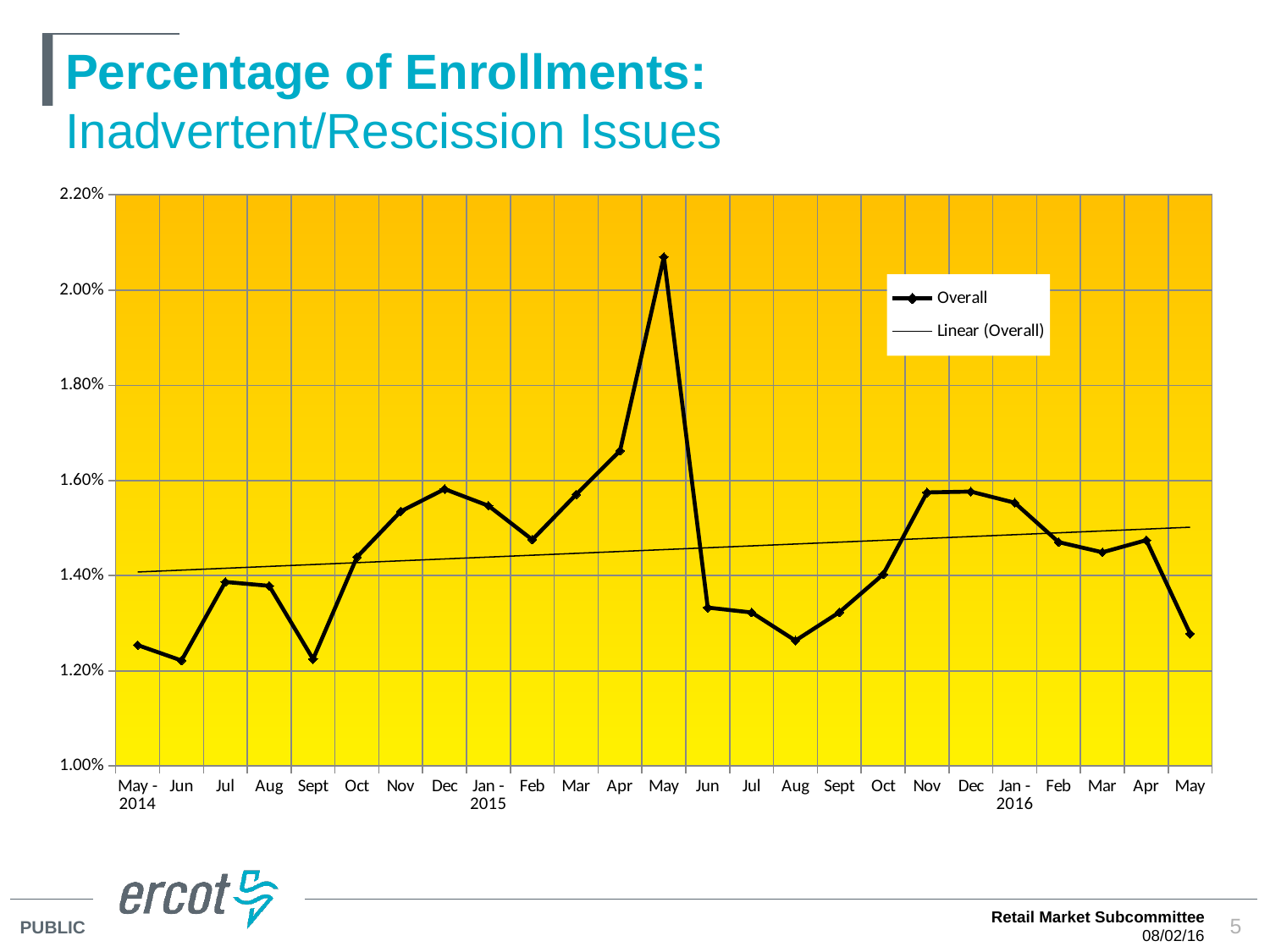
Is the Overall value for May 2015 greater or less than 2.00%? greater Is the Overall value for May 2016 greater or less than 1.40%? less What kind of chart is shown on the slide? line chart Which is larger, the Overall value for Dec 2014 or for Jun 2014? Dec 2014 Which month has the highest Overall value? May 2015 How many series does the legend list? 2 Does the Linear (Overall) trend line rise or fall from left to right? rise Is the Overall value for Aug 2015 greater or less than 1.40%? less What are the two entries in the chart legend? Overall and Linear (Overall) How many monthly data points are plotted on the Overall line? 25